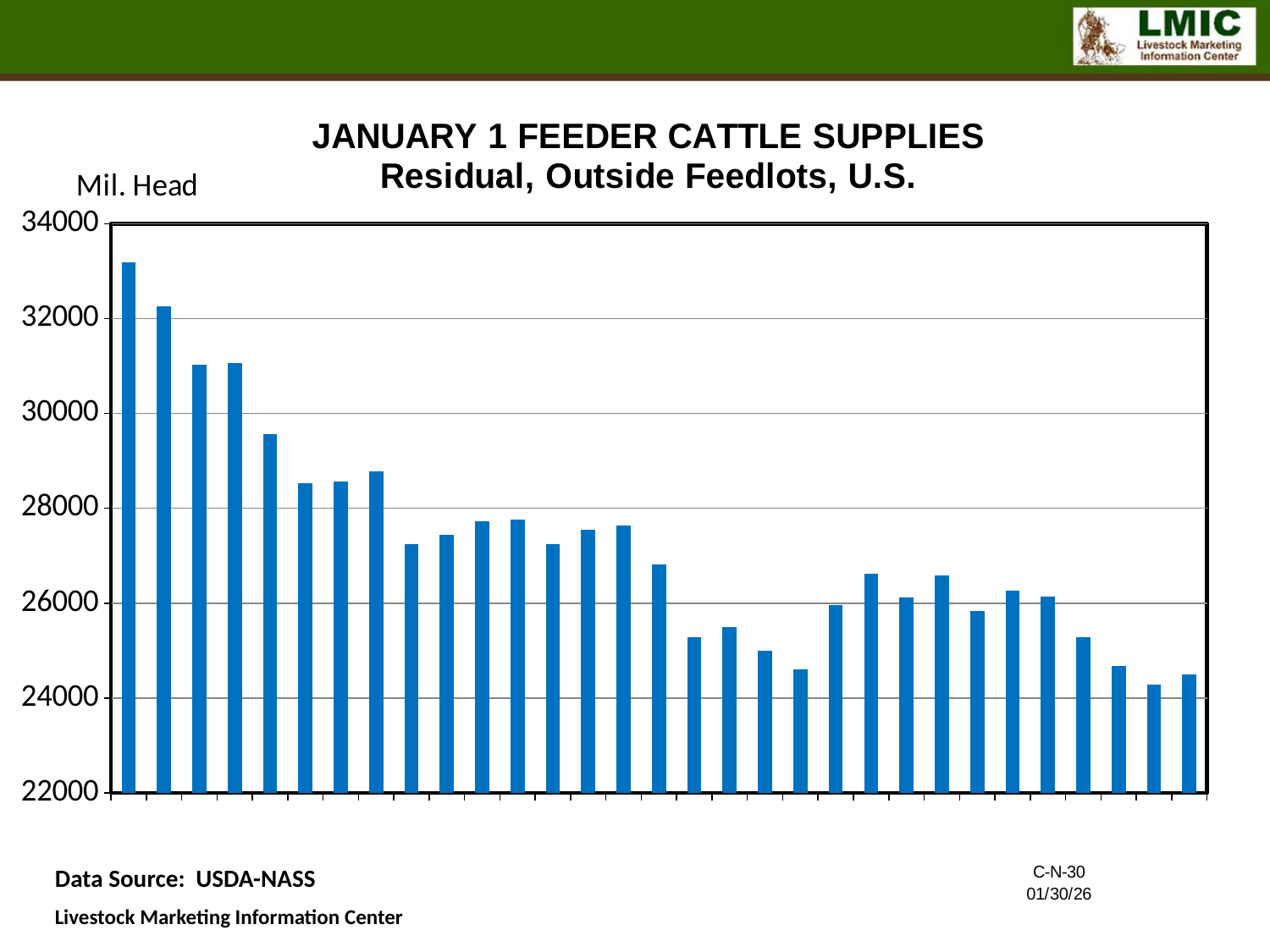
Which is larger, the leftmost bar or the rightmost bar? the leftmost bar What is the highest value shown on the y axis? 34000 How many bars are plotted in the chart? 31 Do the values generally rise or fall from left to right across the chart? fall Is the value of the leftmost bar greater or less than 32000? greater What unit is shown on the y axis of the chart? Mil. Head What is the title of the chart? JANUARY 1 FEEDER CATTLE SUPPLIES Residual, Outside Feedlots, U.S. Which bar is the highest in the chart? the leftmost (first) bar What kind of chart is shown on the slide? bar chart Is the value of the lowest bar greater or less than 24000? greater Is the value of the rightmost bar greater or less than 26000? less